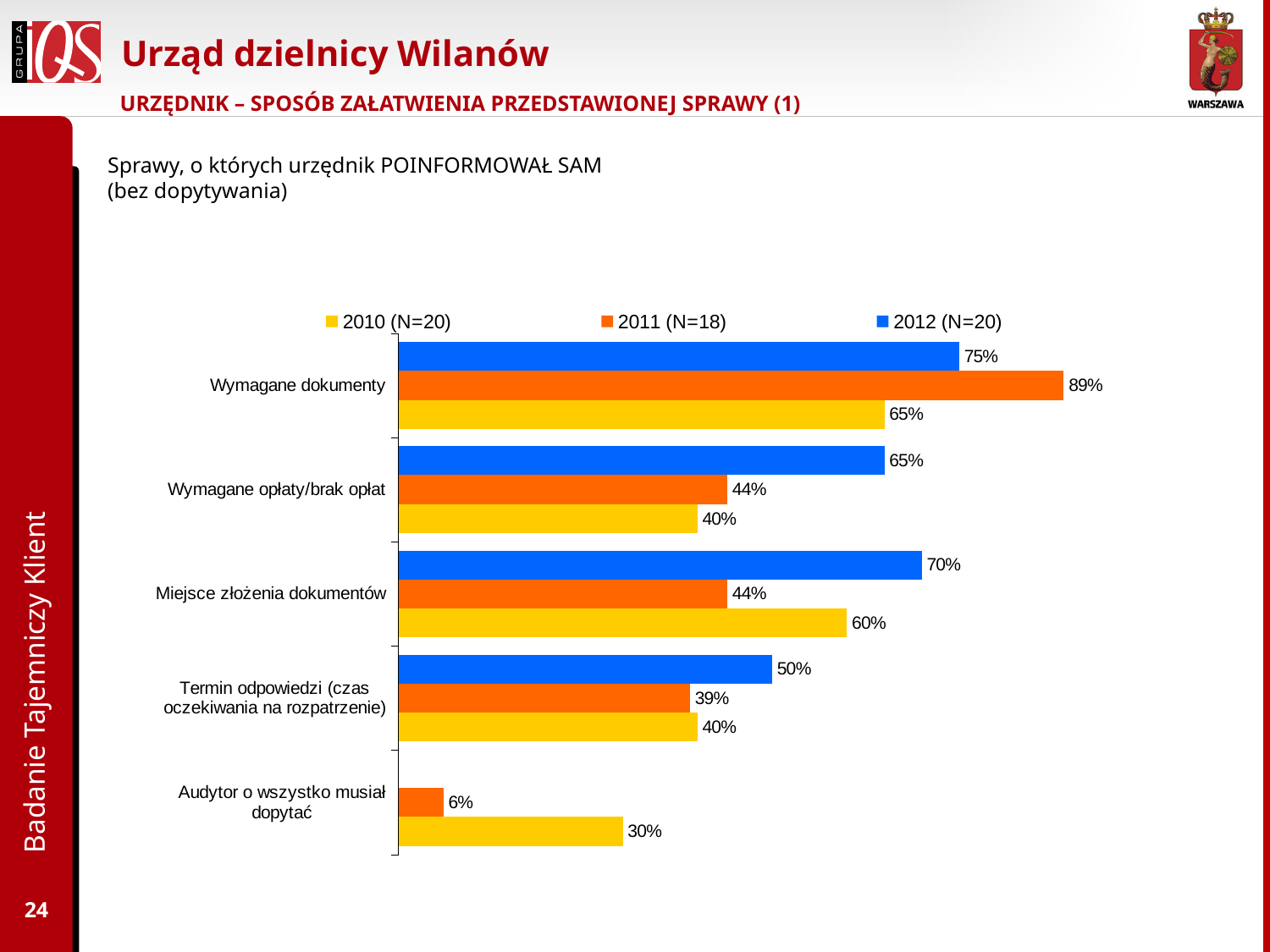
Which is larger for 'Miejsce złożenia dokumentów': the 2010 (N=20) value or the 2011 (N=18) value? 2010 (N=20) What kind of chart is shown on the slide? Bar chart How many series does the legend list? 3 Which category has the highest value in the 2012 (N=20) series? Wymagane dokumenty How many categories are shown on the chart? 5 What is the difference between the 2012 (N=20) and 2011 (N=18) values for 'Miejsce złożenia dokumentów'? 26% Which category has the lowest value in the 2011 (N=18) series? Audytor o wszystko musiał dopytać What is the value for 'Wymagane dokumenty' in the 2011 (N=18) series? 89% What is the value for 'Wymagane opłaty/brak opłat' in the 2012 (N=20) series? 65% What is the difference between the 2011 (N=18) and 2010 (N=20) values for 'Wymagane dokumenty'? 24% What is the value for 'Termin odpowiedzi (czas oczekiwania na rozpatrzenie)' in the 2011 (N=18) series? 39% What is the value for 'Audytor o wszystko musiał dopytać' in the 2010 (N=20) series? 30%